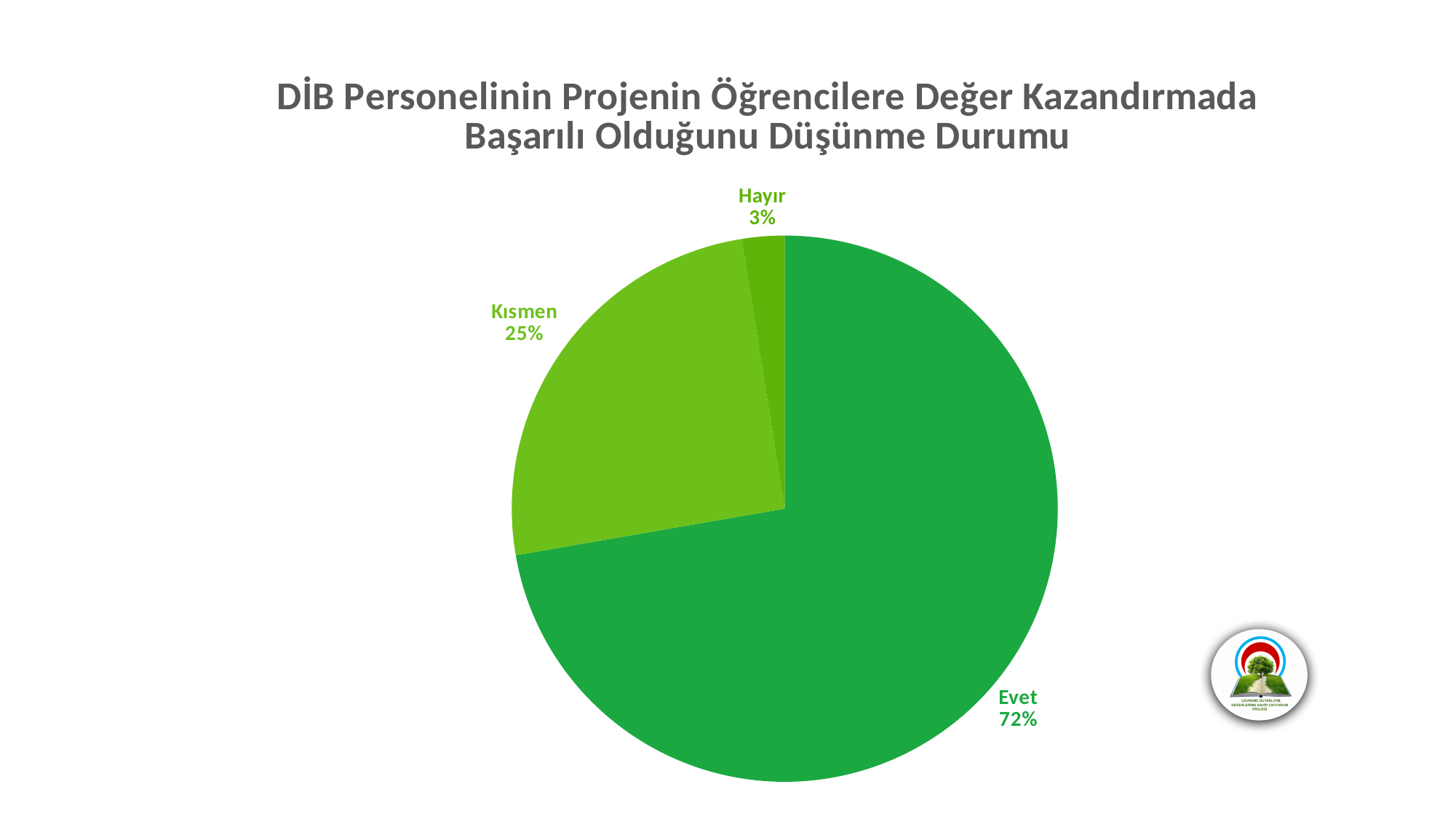
What kind of chart is shown on the slide? pie chart How many slices does the pie chart have? 3 Is the share for Evet greater or less than 50%? greater What is the difference in percentage points between the Kısmen and Hayır slices? 22 What share of the pie does the Hayır slice represent? 3% Which slice is larger, Kısmen or Hayır? Kısmen What share of the pie does the Evet slice represent? 72% Which category has the smallest slice of the pie? Hayır What is the difference in percentage points between the Evet and Kısmen slices? 47 What is the title of the chart? DİB Personelinin Projenin Öğrencilere Değer Kazandırmada Başarılı Olduğunu Düşünme Durumu What share of the pie does the Kısmen slice represent? 25% Which category has the largest slice of the pie? Evet